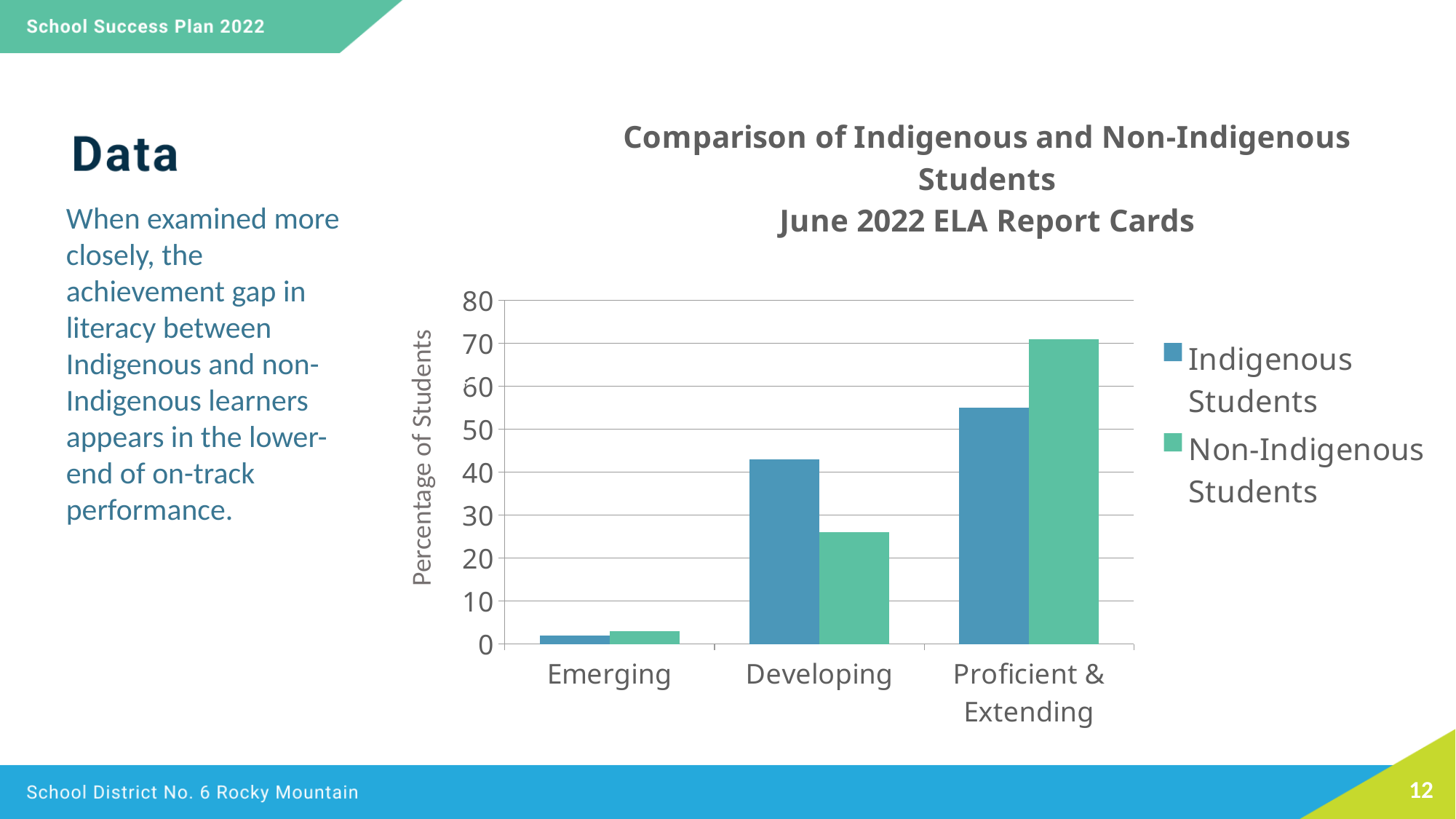
Is the value for Non-Indigenous Students in Developing greater or less than 30? less How many series does the legend list? 2 In the Developing category, which series has the larger value, Indigenous Students or Non-Indigenous Students? Indigenous Students Which category has the lowest value for Indigenous Students? Emerging Which category has the highest value for Non-Indigenous Students? Proficient & Extending Is the value for Indigenous Students in Developing greater or less than 40? greater Which series is shown in green in the chart? Non-Indigenous Students In the Proficient & Extending category, which series has the larger value, Indigenous Students or Non-Indigenous Students? Non-Indigenous Students Is the value for Non-Indigenous Students in Proficient & Extending greater or less than 60? greater How many categories are shown on the x axis? 3 What kind of chart is shown on the slide? bar chart What is the label on the vertical axis of the chart? Percentage of Students